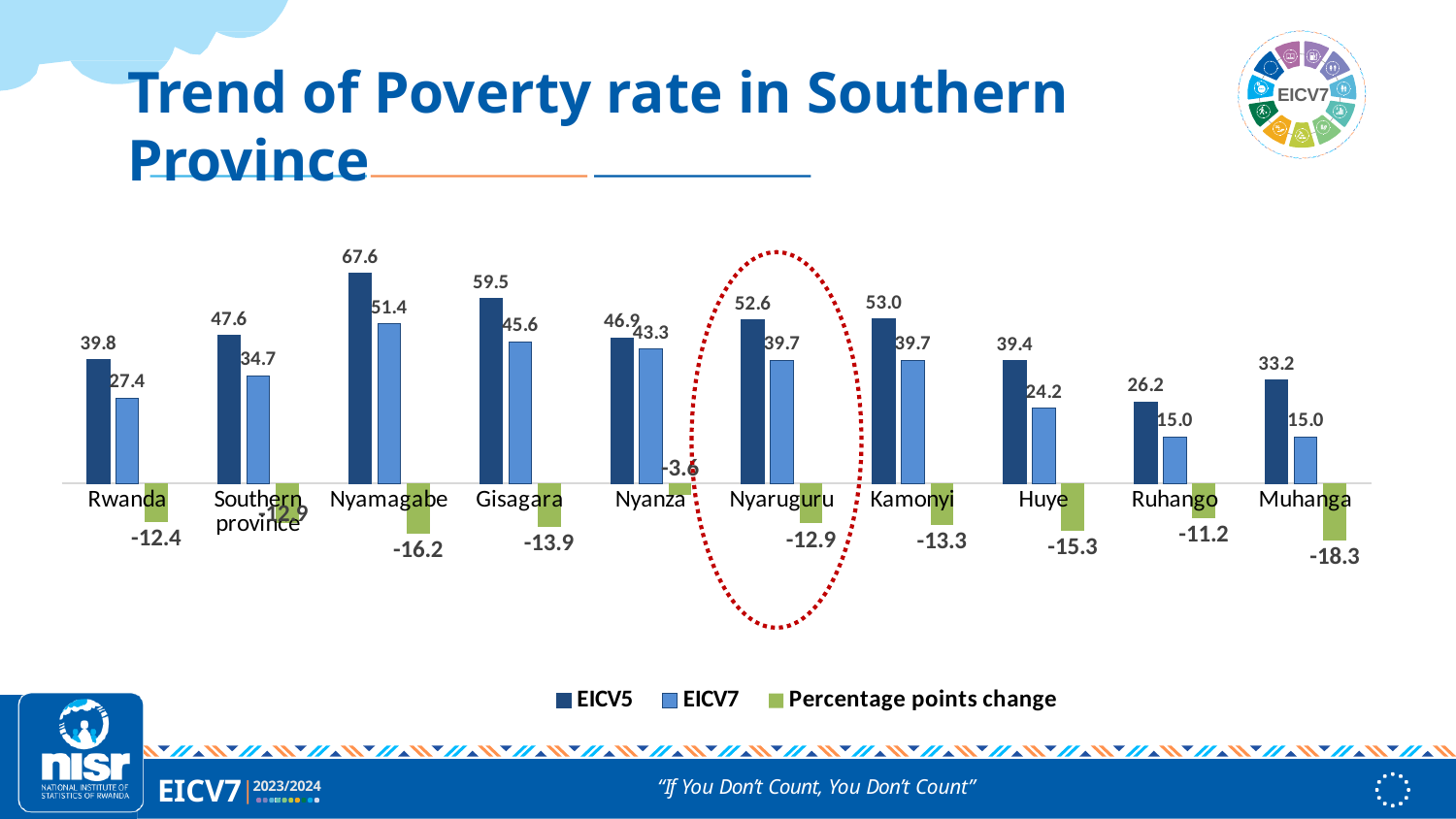
What is the EICV7 poverty rate for Huye? 24.2 What kind of chart is shown on the slide? Bar chart How many series does the legend list? 3 Which category has the highest EICV5 poverty rate? Nyamagabe How many categories are shown on the x axis? 10 Which category has the smallest percentage points change (closest to zero)? Nyanza What is the difference between the EICV5 and EICV7 poverty rates for Gisagara? 13.9 What is the EICV5 poverty rate for Nyamagabe? 67.6 Which is larger, the EICV5 poverty rate for Kamonyi or for Nyaruguru? Kamonyi What is the EICV7 poverty rate for Nyaruguru? 39.7 What is the percentage points change shown for Muhanga? -18.3 Which category has the lowest EICV5 poverty rate? Ruhango